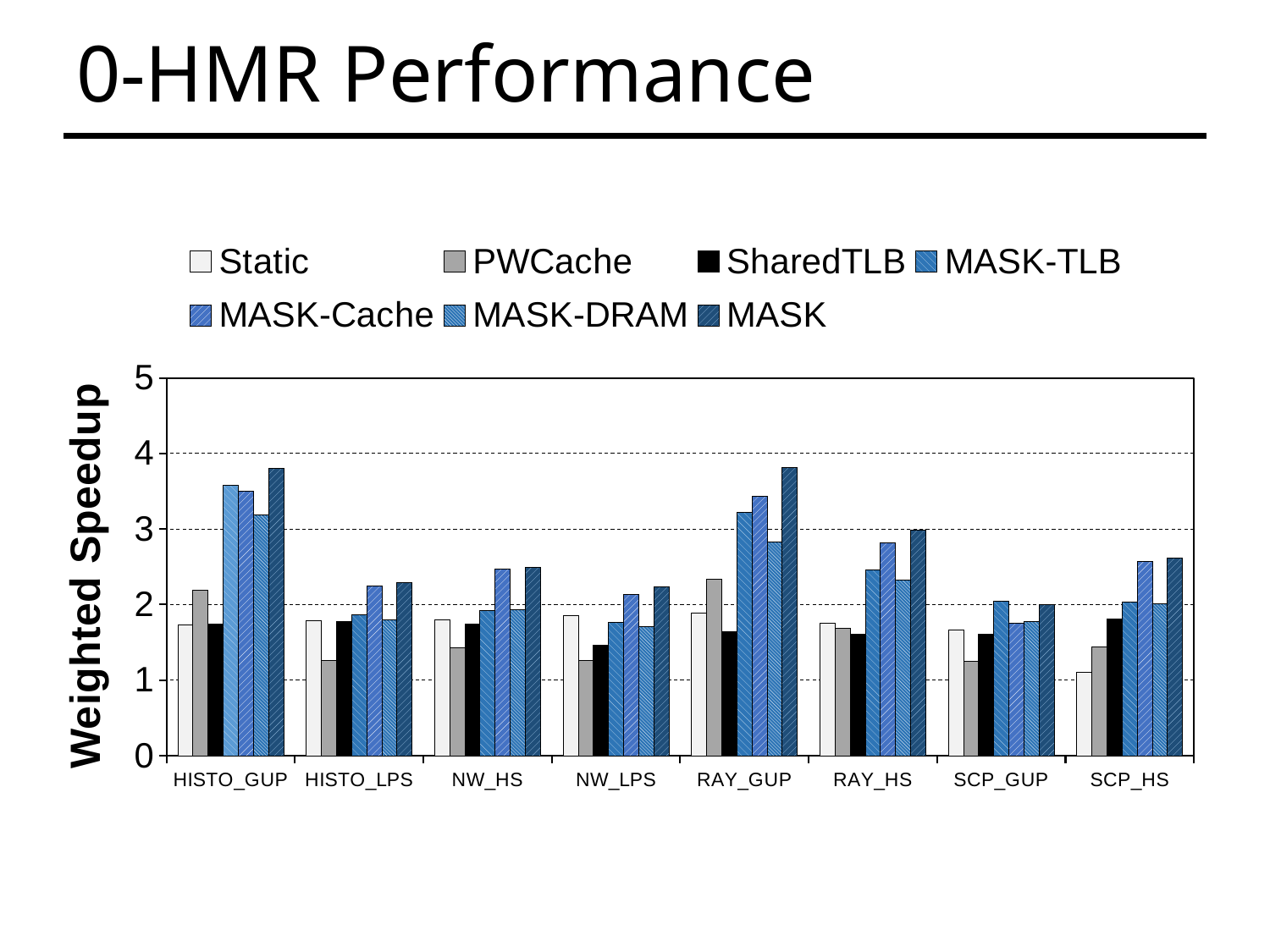
How many series does the legend list? 7 For RAY_HS, which is larger: the MASK value or the Static value? MASK Which series has the lowest weighted speedup for SCP_HS? Static Is the Static value for SCP_HS greater or less than 2? less What kind of chart is shown on the slide? bar chart How many workload categories are shown on the x axis? 8 Which series has the lowest weighted speedup for HISTO_LPS? PWCache Is the PWCache value for HISTO_LPS greater or less than 2? less What is the label of the y axis? Weighted Speedup Which series has the highest weighted speedup for HISTO_GUP? MASK Is the MASK-Cache value for RAY_GUP greater or less than 3? greater